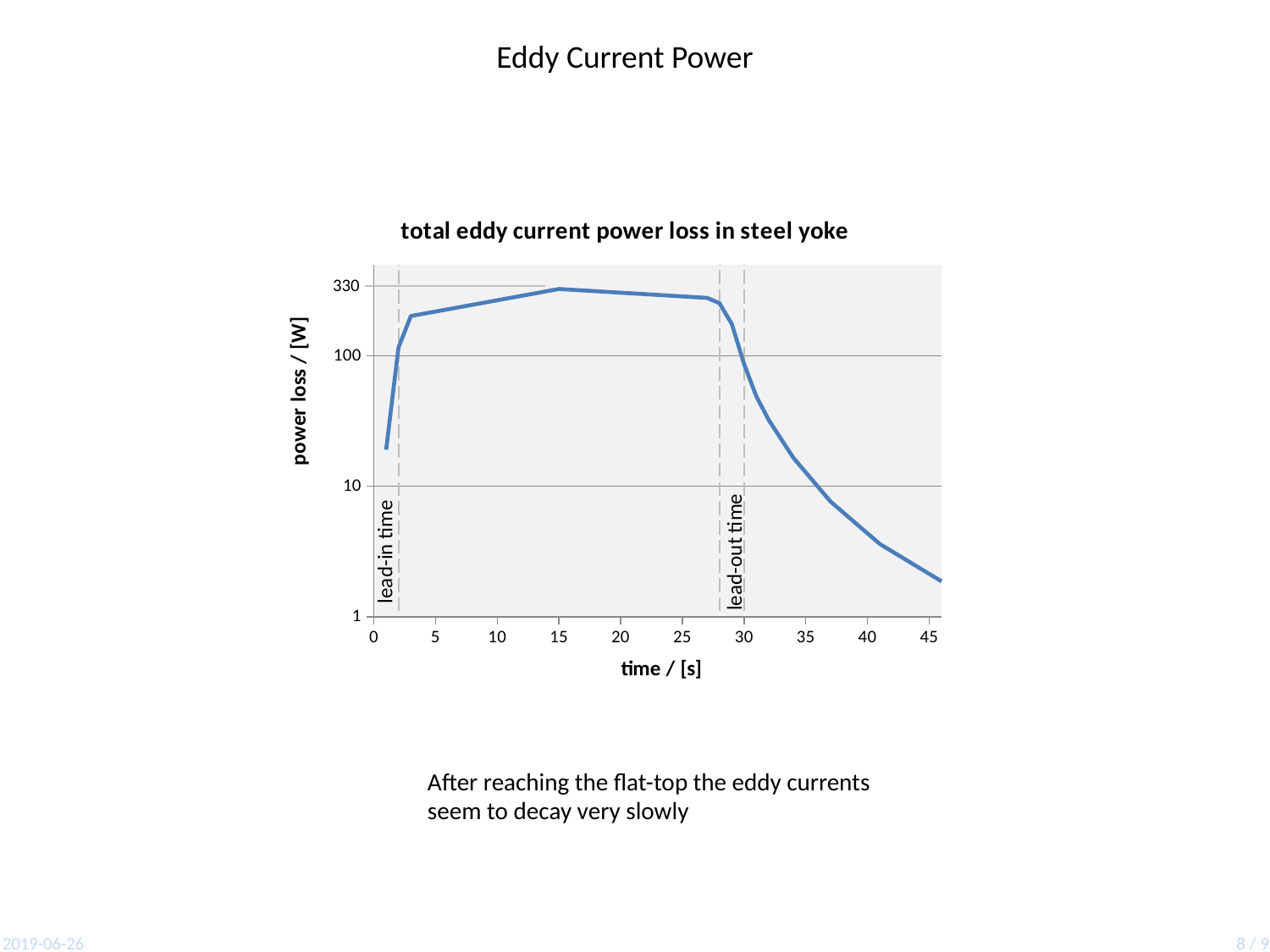
Does the power loss rise or fall between 0 s and 15 s? rise What is the title of the chart? total eddy current power loss in steel yoke Is the power loss at time 5 s greater or less than 100 W? greater Which is larger, the power loss at 15 s or at 40 s? 15 s Does the power loss rise or fall between 30 s and 45 s? fall Is the power loss at time 45 s greater or less than 1 W? greater Is the power loss at time 40 s greater or less than 10 W? less What kind of chart is shown on the slide? line chart What is the label of the x axis? time / [s]